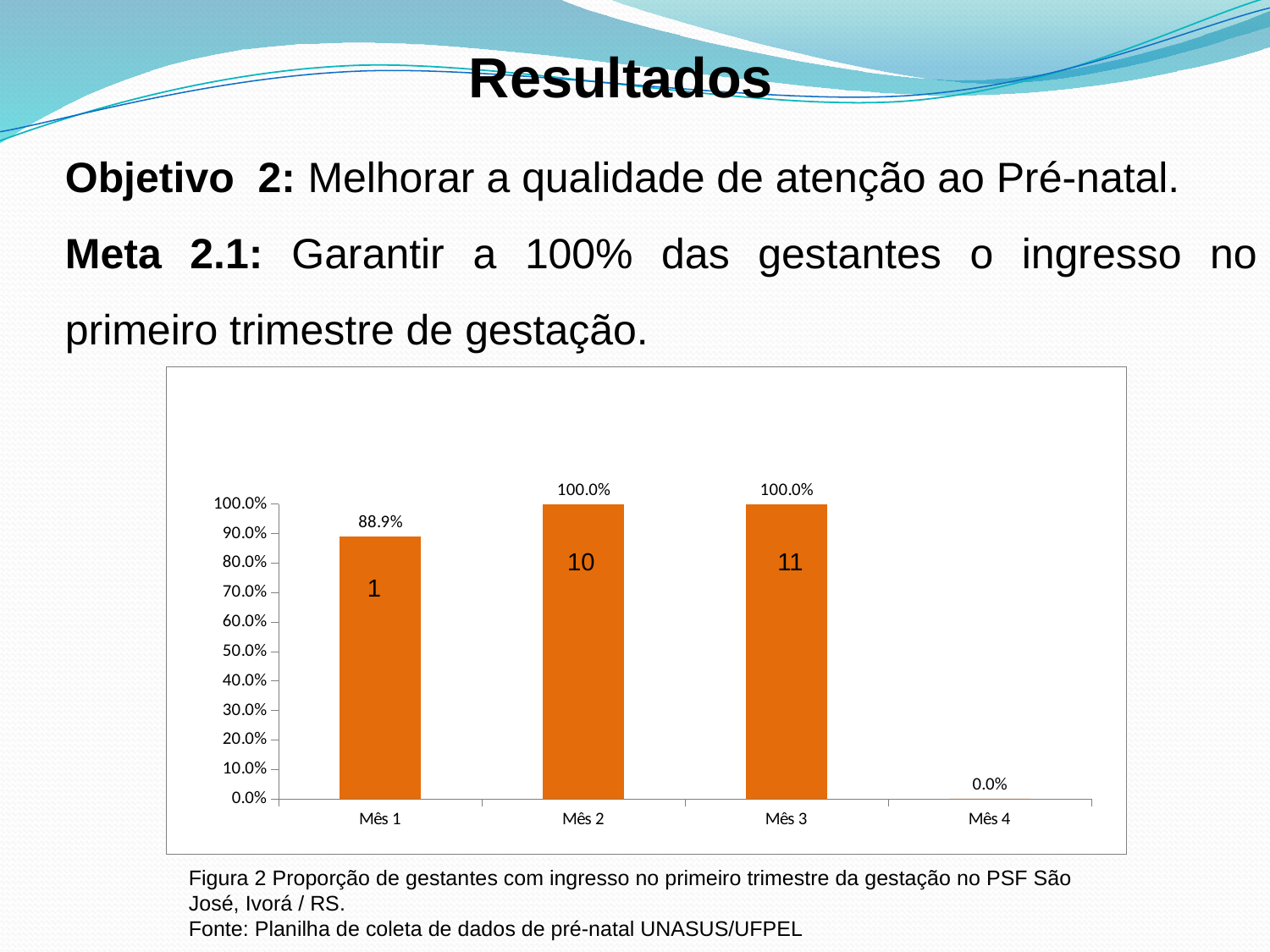
Which is larger, the value for Mês 1 or the value for Mês 3? Mês 3 What is the difference between the values for Mês 2 and Mês 1? 11.1% What is the value for Mês 1? 88.9% What is the value for Mês 2? 100.0% Is the value for Mês 1 greater or less than 80.0%? greater Which month has the lowest value? Mês 4 What is the value for Mês 4? 0.0% What colour are the bars in the chart? orange How many months are shown on the x axis? 4 What number is printed inside the bar for Mês 1? 1 What kind of chart is shown on the slide? bar chart What number is printed inside the bar for Mês 3? 11